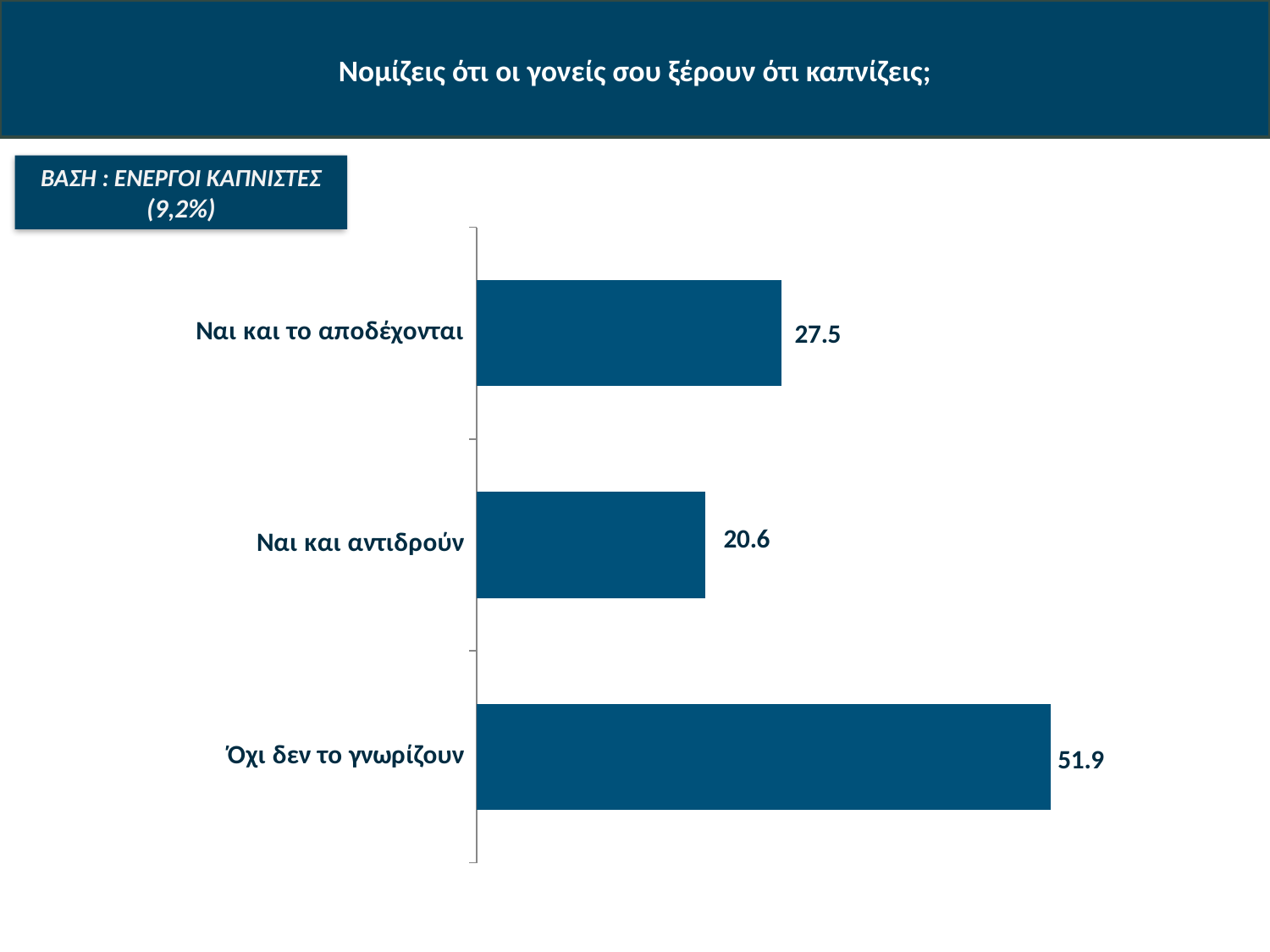
What kind of chart is shown on the slide? Bar chart What is the difference between the values for "Ναι και το αποδέχονται" and "Ναι και αντιδρούν"? 6.9 What base is stated in the box at the top left of the slide? ΒΑΣΗ : ΕΝΕΡΓΟΙ ΚΑΠΝΙΣΤΕΣ (9,2%) What is the difference between the values for "Όχι δεν το γνωρίζουν" and "Ναι και το αποδέχονται"? 24.4 Which category has the highest value? Όχι δεν το γνωρίζουν Which is larger, the value for "Ναι και το αποδέχονται" or the value for "Ναι και αντιδρούν"? Ναι και το αποδέχονται Which category has the lowest value? Ναι και αντιδρούν What is the value for "Όχι δεν το γνωρίζουν"? 51.9 What is the value for "Ναι και το αποδέχονται"? 27.5 How many categories are shown in the chart? 3 What is the value for "Ναι και αντιδρούν"? 20.6 What is the title of the slide? Νομίζεις ότι οι γονείς σου ξέρουν ότι καπνίζεις;